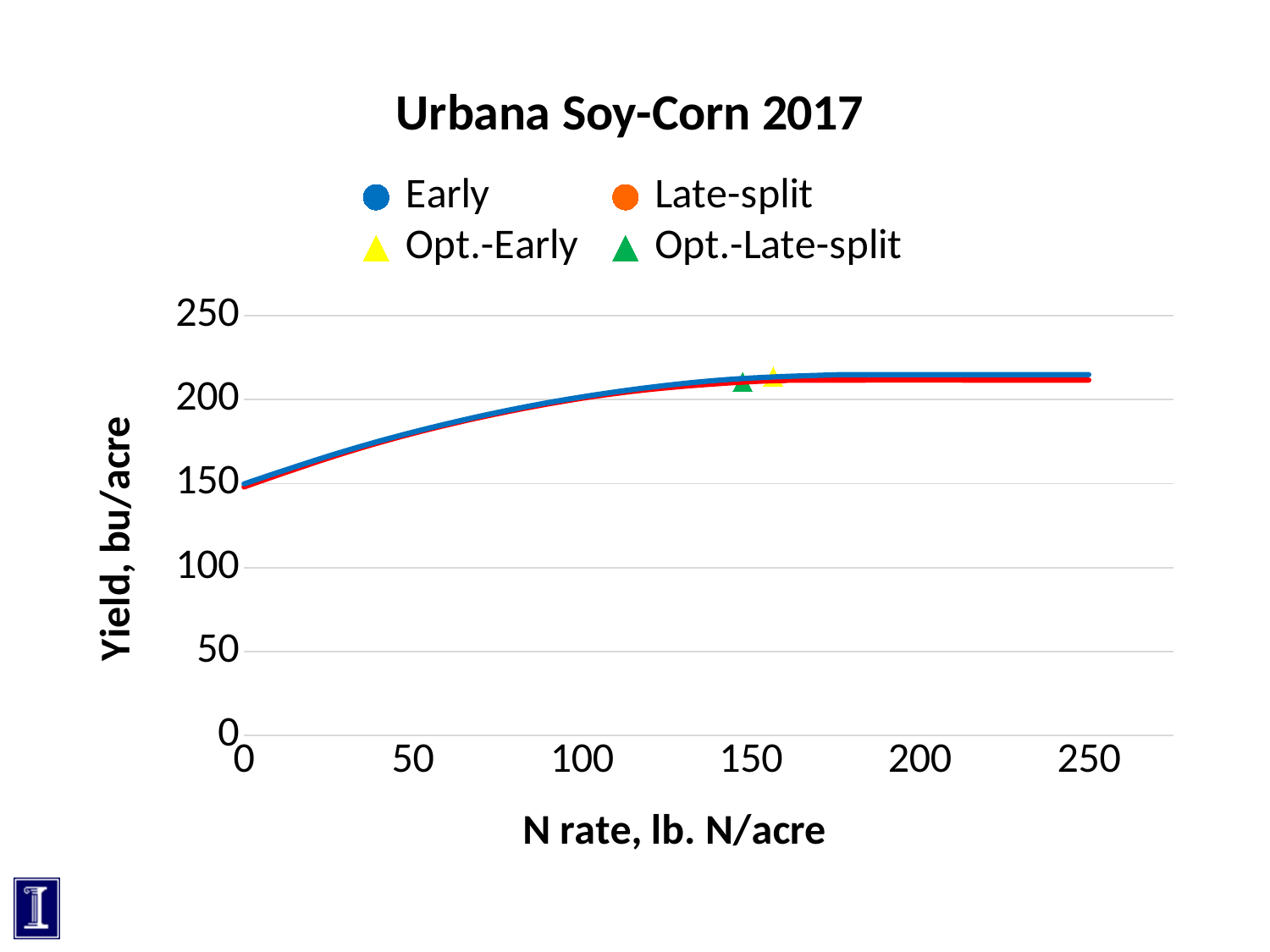
What is the label of the y axis? Yield, bu/acre Does the Early yield curve rise or fall as N rate increases from 0 to 150? rise Is the Early yield at an N rate of 100 greater or less than 250 bu/acre? less What is the title of the chart? Urbana Soy-Corn 2017 How many series does the legend list? 4 What kind of chart is shown on the slide? line chart Is the yield at the Opt.-Late-split marker greater or less than 150 bu/acre? greater Is the Early yield at an N rate of 0 greater or less than 200 bu/acre? less